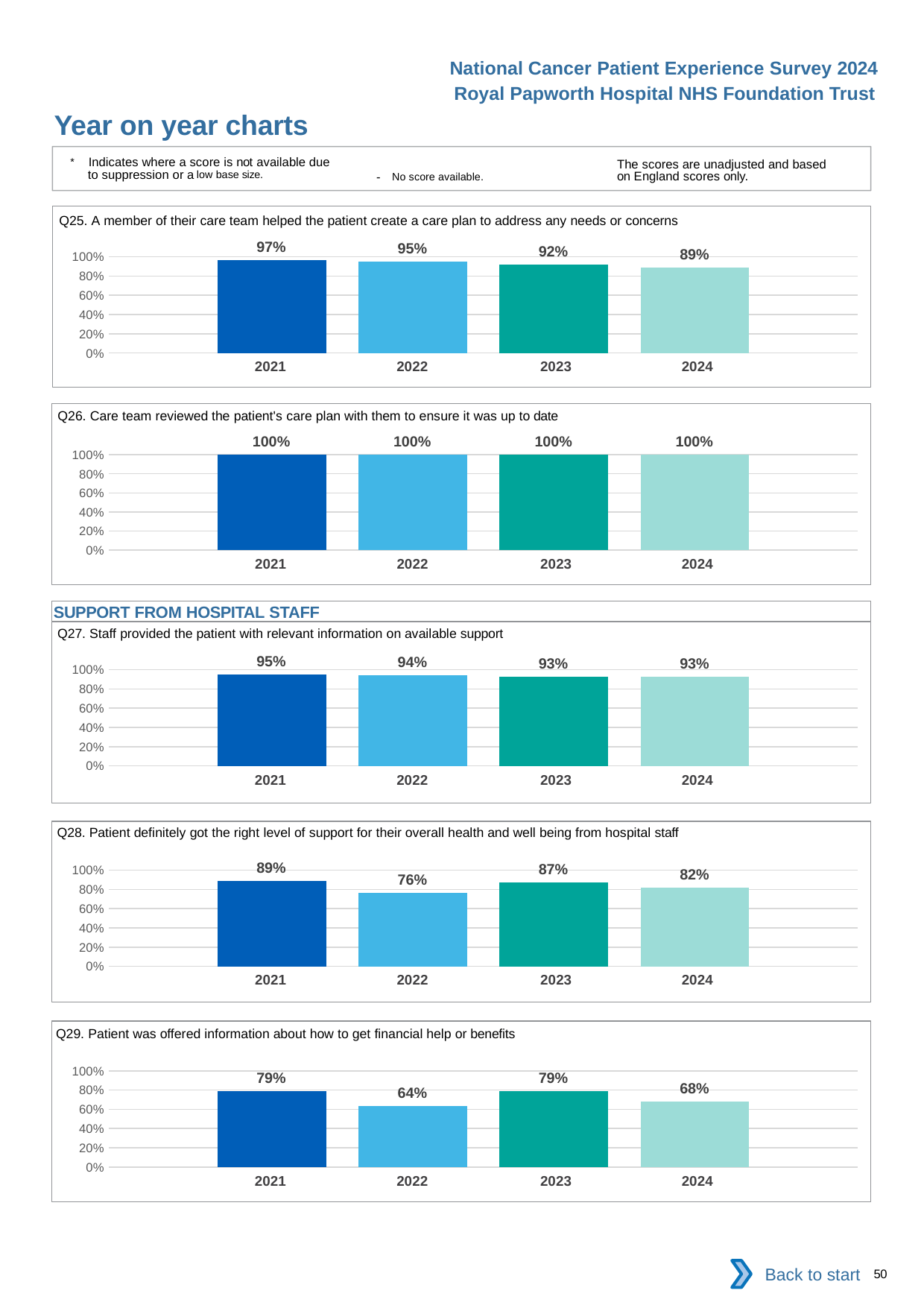
In the Q25 chart, which year has the highest value? 2021 In the Q27 chart, how many years are plotted? 4 In the Q29 chart, what is the value for 2022? 64% What kind of chart is the Q29 chart? bar chart In the Q25 chart, what is the value for 2024? 89% In the Q26 chart, what is the value for 2023? 100% In the Q28 chart, which is larger, the value for 2021 or the value for 2024? 2021 In the Q27 chart, what is the difference between the 2021 and 2024 values? 2% In the Q25 chart, do the values rise or fall from 2021 to 2024? fall In the Q29 chart, what is the difference between the 2023 and 2024 values? 11% In the Q28 chart, what is the value for 2023? 87% In the Q28 chart, which year has the lowest value? 2022